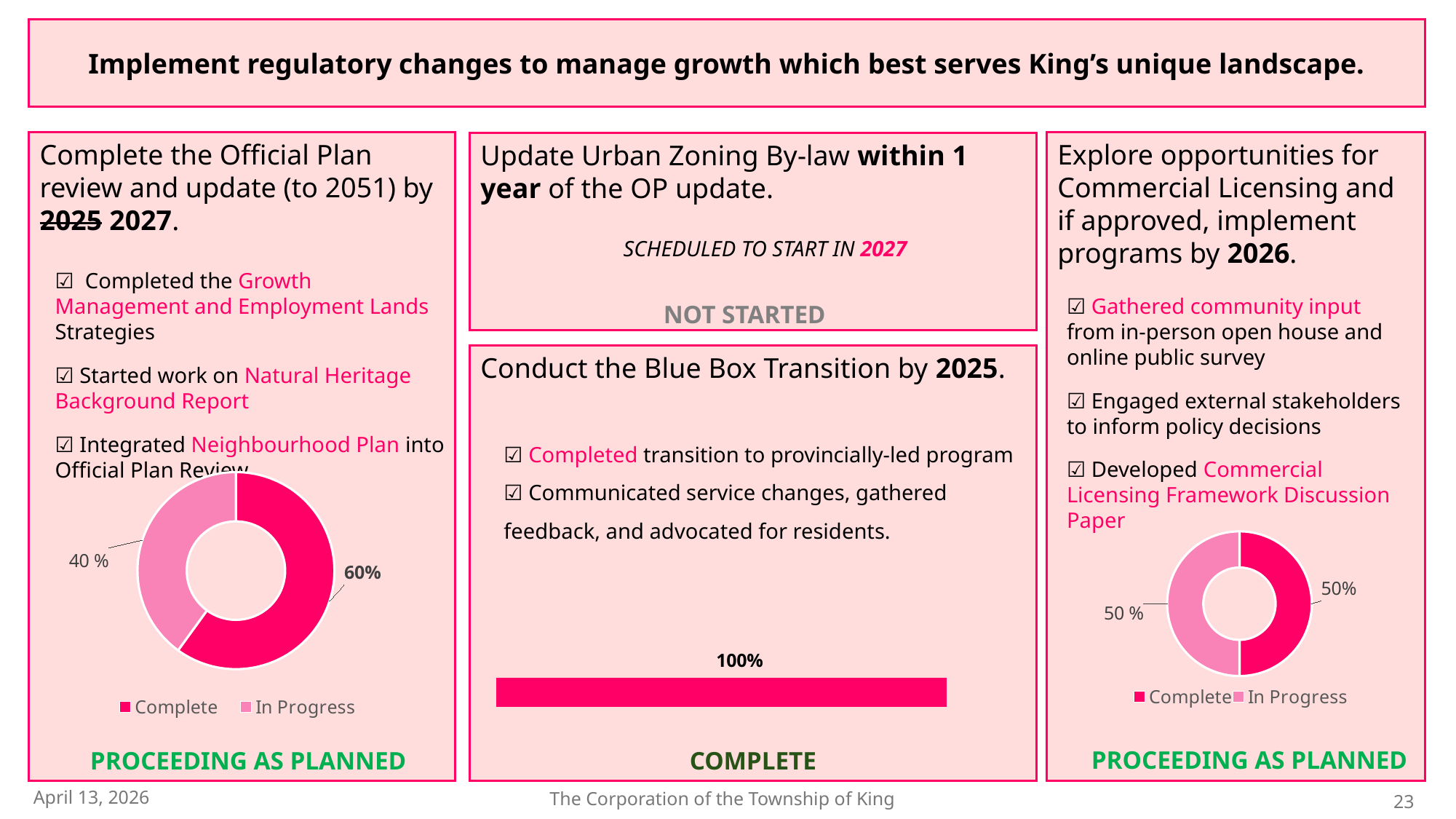
In the left panel's doughnut chart (Official Plan review), what is the difference in percentage points between the Complete and In Progress slices? 20 In the right panel's doughnut chart (Commercial Licensing), what share is labelled In Progress? 50 % What kind of chart is shown in the left panel (Official Plan review)? Doughnut chart In the right panel's doughnut chart (Commercial Licensing), what share is labelled Complete? 50% How many entries does the legend of the left panel's doughnut chart list? 2 In the left panel's doughnut chart (Official Plan review), which slice is larger, Complete or In Progress? Complete In the right panel's doughnut chart (Commercial Licensing), which legend entry is shown in the darker pink colour? Complete In the left panel's doughnut chart (Official Plan review), what share is labelled In Progress? 40 % In the middle panel's chart (Blue Box Transition), what value is printed above the bar? 100% In the left panel's doughnut chart (Official Plan review), what share is labelled Complete? 60% How many slices does the right panel's doughnut chart (Commercial Licensing) have? 2 What kind of chart is shown in the middle panel (Blue Box Transition)? Bar chart